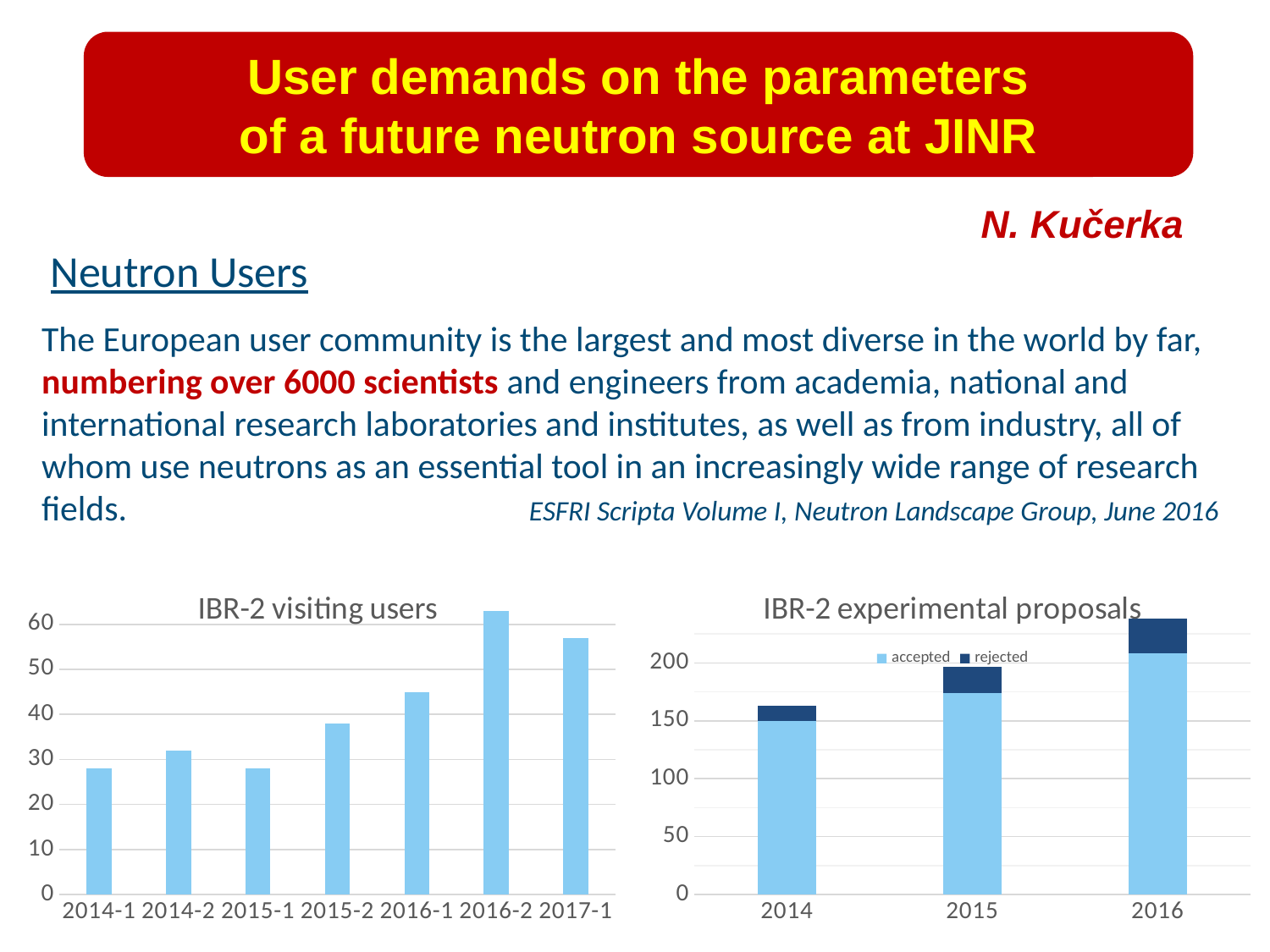
In the "IBR-2 visiting users" chart, which category has the highest value? 2016-2 In the "IBR-2 experimental proposals" chart, which year has the tallest stacked bar? 2016 In the "IBR-2 visiting users" chart, which is larger, the value for 2016-1 or the value for 2015-2? 2016-1 In the "IBR-2 visiting users" chart, is the value for 2016-2 greater or less than 60? greater In the "IBR-2 visiting users" chart, do the values generally rise or fall from 2015-1 to 2016-2? rise What are the two series named in the legend of the "IBR-2 experimental proposals" chart? accepted and rejected How many categories are shown on the x axis of the "IBR-2 visiting users" chart? 7 How many series does the legend of the "IBR-2 experimental proposals" chart list? 2 What kind of chart is the "IBR-2 visiting users" chart? bar chart In the "IBR-2 visiting users" chart, is the value for 2014-1 greater or less than 30? less How many years are shown on the x axis of the "IBR-2 experimental proposals" chart? 3 In the "IBR-2 experimental proposals" chart, is the accepted value for 2016 greater or less than 200? greater